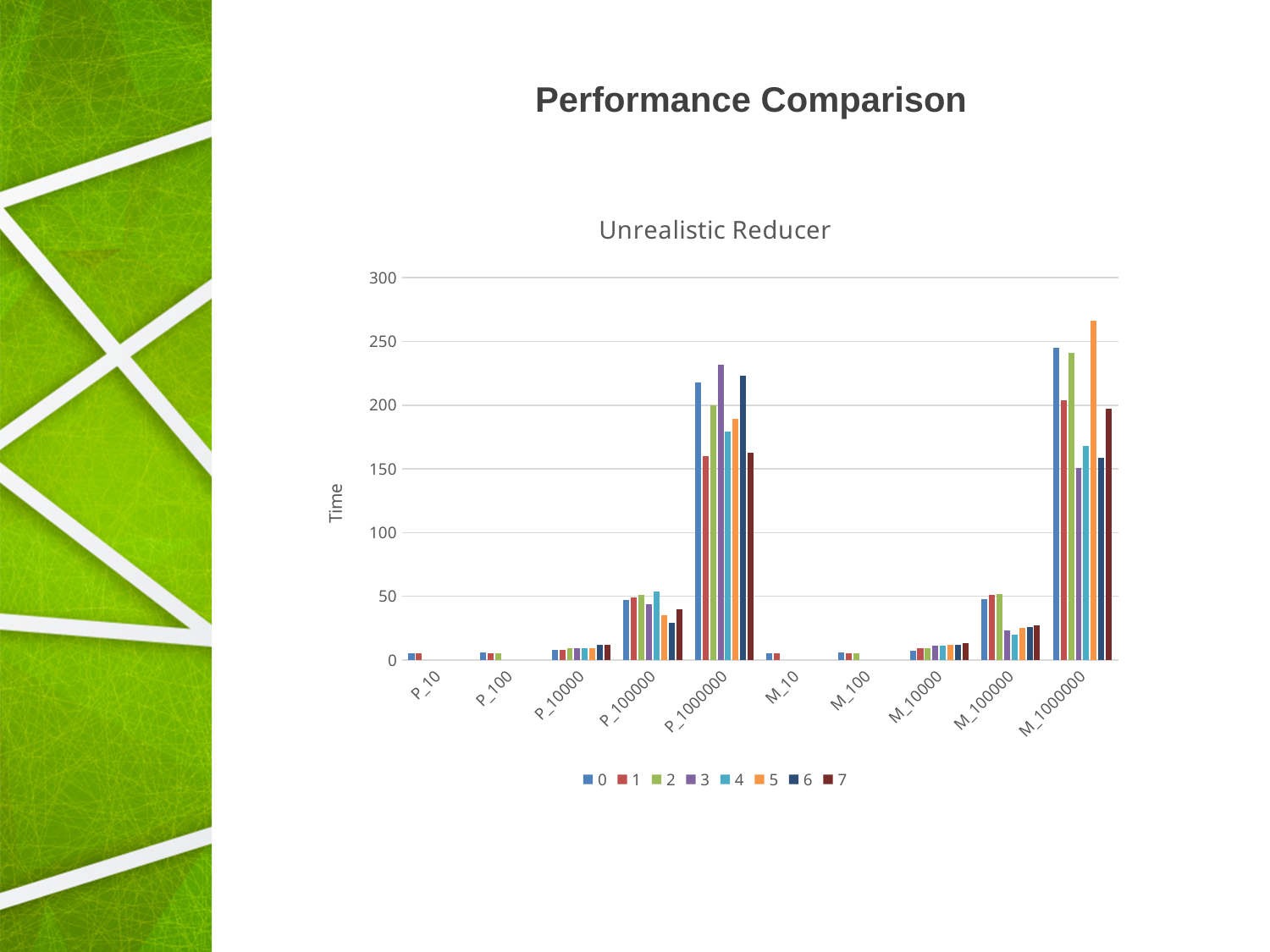
How many categories are shown on the x axis? 10 What is the label of the vertical axis? Time For P_1000000, which is larger: the value of series 0 or series 1? series 0 What type of chart is shown on the slide? bar chart Is the value of series 0 for P_1000000 greater or less than 200? greater For M_1000000, which is larger: the value of series 4 or series 5? series 5 Is the value of series 1 for P_100000 greater or less than 100? less Is the value of series 4 for P_1000000 greater or less than 200? less How many series does the legend list? 8 Which series has the highest value for M_1000000? 5 What is the title of the chart? Unrealistic Reducer